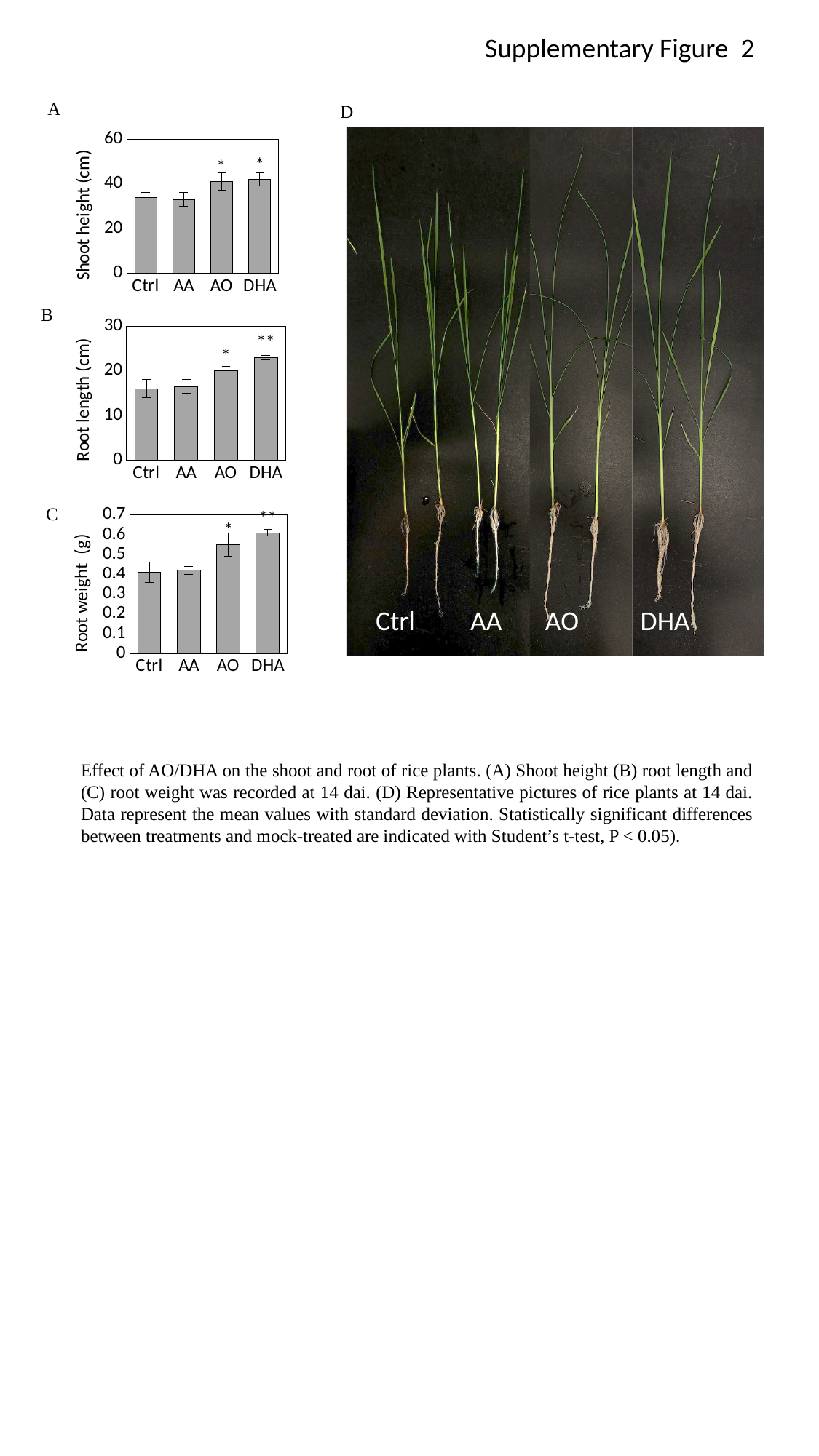
What is the y-axis label of chart C? Root weight (g) In chart B (Root length), is the value for DHA greater or less than 20? greater In chart B (Root length), which is larger, the value for Ctrl or the value for DHA? DHA In chart C (Root weight), which category has the highest value? DHA In chart B (Root length), is the value for Ctrl greater or less than 20? less What kind of chart is chart A (Shoot height)? bar chart In chart C (Root weight), is the value for Ctrl greater or less than 0.5? less How many categories are shown on the x axis of chart B (Root length)? 4 In chart B (Root length), which category has the highest value? DHA In chart C (Root weight), which is larger, the value for AA or the value for AO? AO